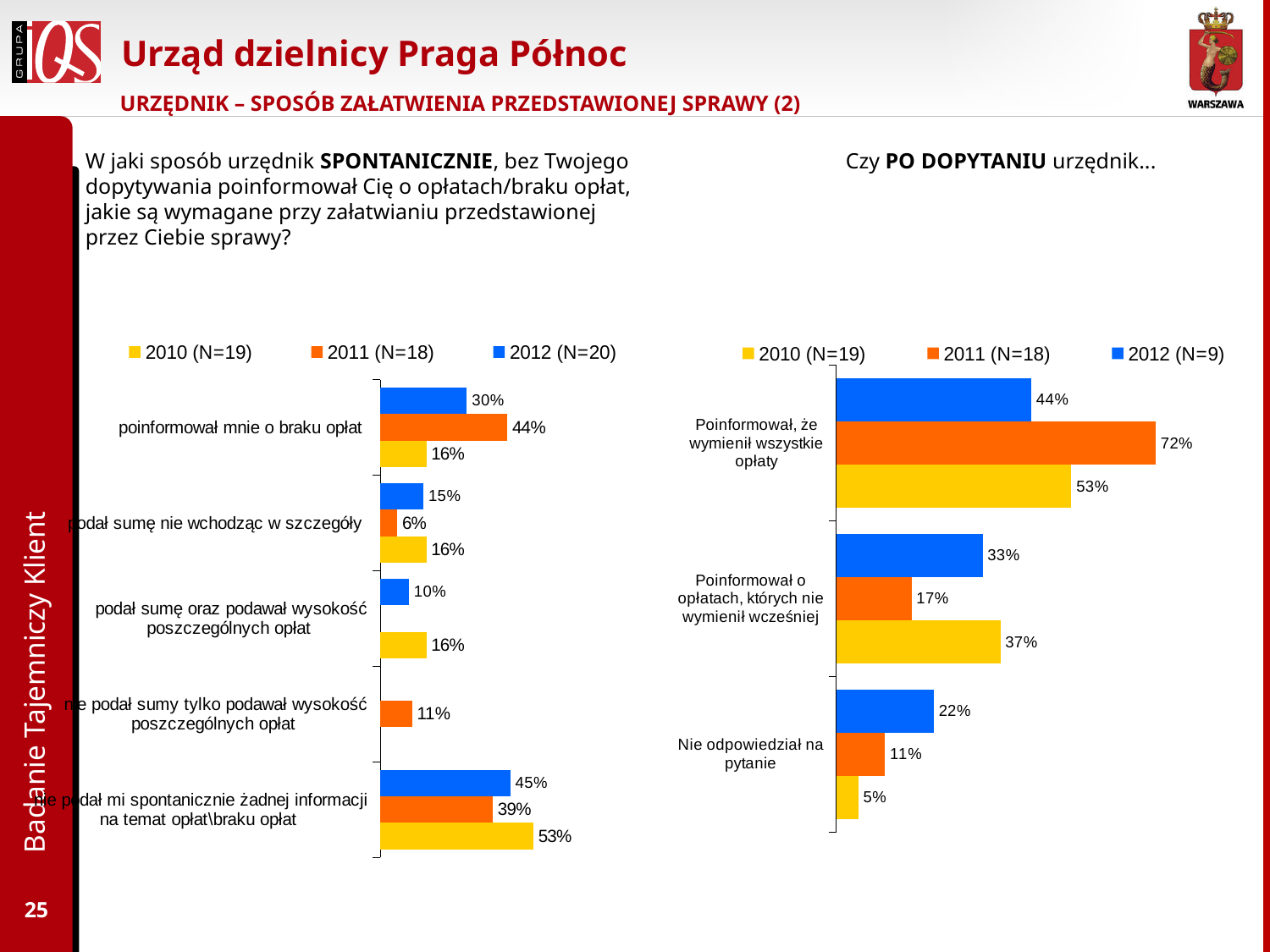
In the left chart (SPONTANICZNIE), what is the 2012 value for 'poinformował mnie o braku opłat'? 30% In the right chart (Czy PO DOPYTANIU urzędnik...), which year has the highest value for 'Poinformował, że wymienił wszystkie opłaty'? 2011 (N=18) In the right chart (Czy PO DOPYTANIU urzędnik...), is the 2012 value for 'Poinformował o opłatach, których nie wymienił wcześniej' larger or smaller than the 2010 value? smaller In the left chart (SPONTANICZNIE), which year has the lowest value for 'podał sumę nie wchodząc w szczegóły'? 2011 (N=18) In the right chart (Czy PO DOPYTANIU urzędnik...), what is the difference between the 2011 and 2012 values for 'Poinformował, że wymienił wszystkie opłaty'? 28% What type of chart is the right chart (Czy PO DOPYTANIU urzędnik...)? bar chart How many series does the legend of the right chart (Czy PO DOPYTANIU urzędnik...) list? 3 In the left chart (SPONTANICZNIE), what is the difference between the 2011 and 2010 values for 'poinformował mnie o braku opłat'? 28% In the right chart (Czy PO DOPYTANIU urzędnik...), what is the 2010 value for 'Nie odpowiedział na pytanie'? 5% In the left chart (SPONTANICZNIE), what is the 2010 value for 'nie podał mi spontanicznie żadnej informacji na temat opłat\braku opłat'? 53% In the right chart (Czy PO DOPYTANIU urzędnik...), what is the 2011 value for 'Poinformował, że wymienił wszystkie opłaty'? 72% How many categories are shown in the left chart (SPONTANICZNIE)? 5